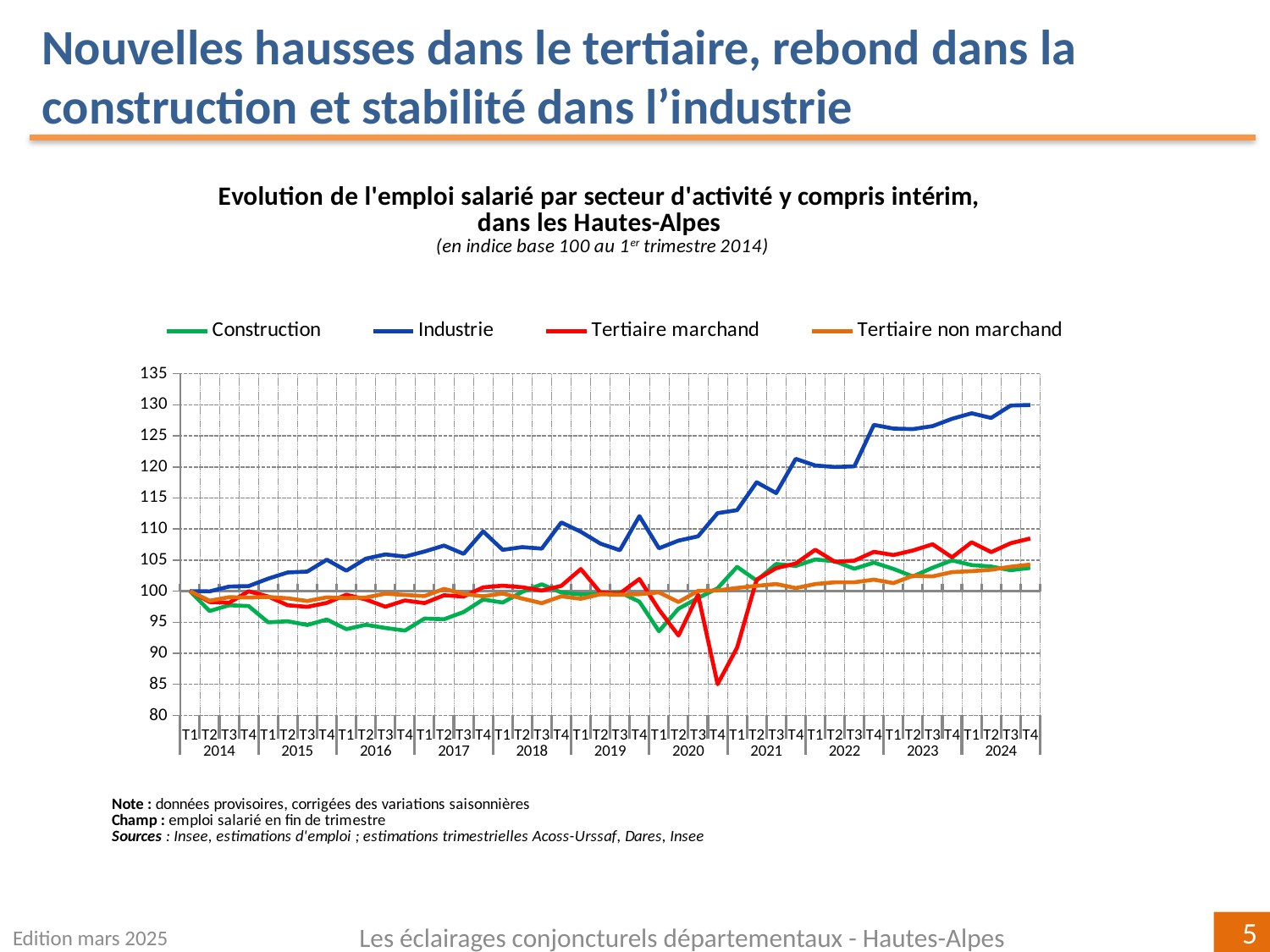
Does the Industrie series generally rise or fall from 2014 to 2024? rise What kind of chart is shown on the slide? line chart At T4 2024, which is higher: Industrie or Construction? Industrie Is the value for Industrie at T4 2022 greater or less than 125? greater How many series does the legend list? 4 Which series are listed in the legend? Construction, Industrie, Tertiaire marchand, Tertiaire non marchand How many years are labelled on the x axis? 11 Is the value for Industrie at T4 2024 greater or less than 125? greater Is the value for Tertiaire marchand at T4 2020 greater or less than 90? less Which series has the highest value at T4 2024? Industrie Which series has the lowest value at T4 2020? Tertiaire marchand